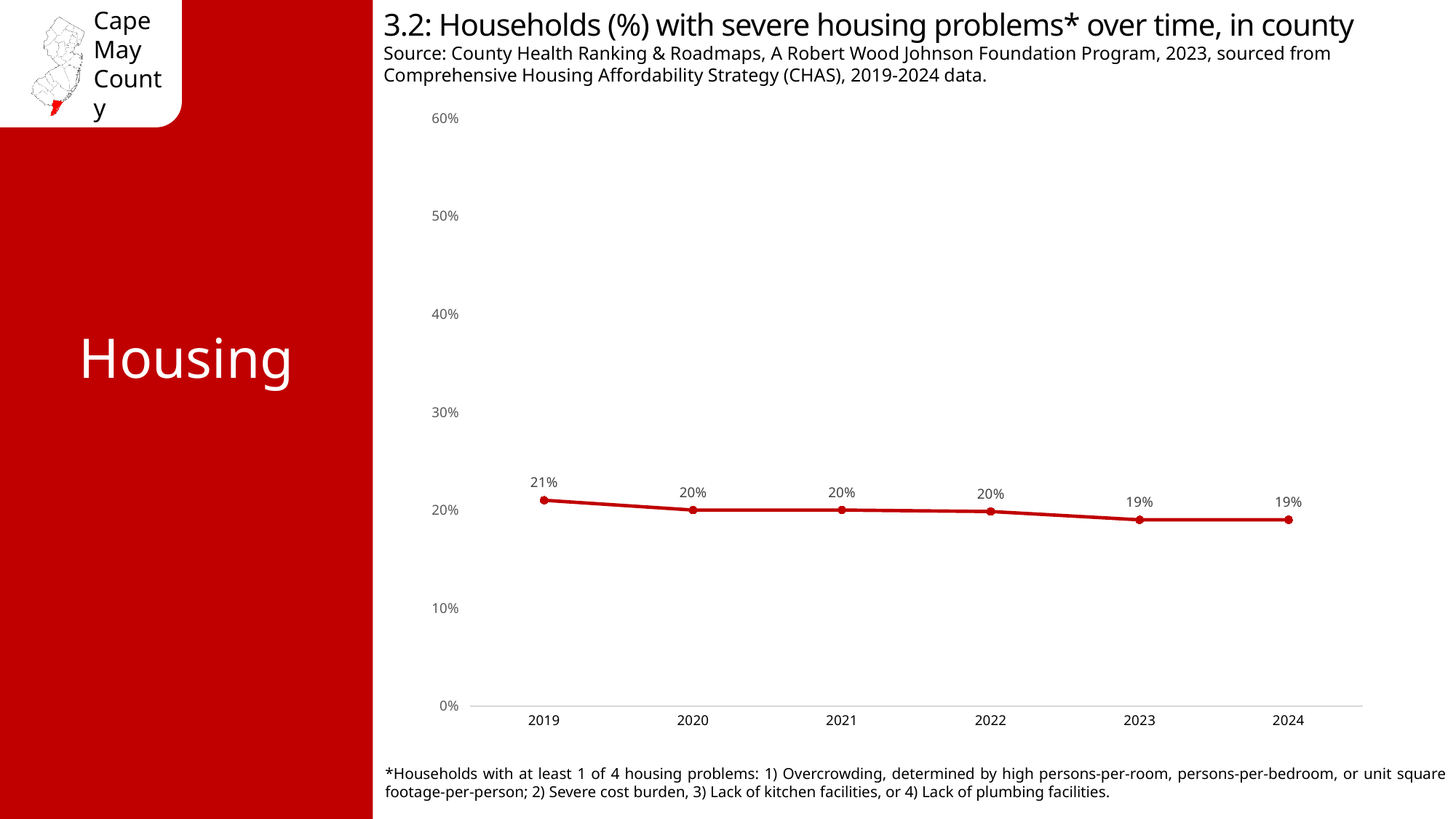
What percentage of households had severe housing problems in 2019? 21% What is the highest value shown on the vertical axis? 60% Is the value for 2021 greater or less than 30%? less What kind of chart is shown on the slide? line chart What is the difference between the 2019 value and the 2024 value? 2% What is the title of the chart? 3.2: Households (%) with severe housing problems* over time, in county What percentage of households had severe housing problems in 2024? 19% How many years are plotted on the chart? 6 What is the value shown for 2022? 20% Which year has the highest percentage of households with severe housing problems? 2019 Do the values rise or fall from 2019 to 2024? fall Which is larger, the value for 2019 or the value for 2023? 2019